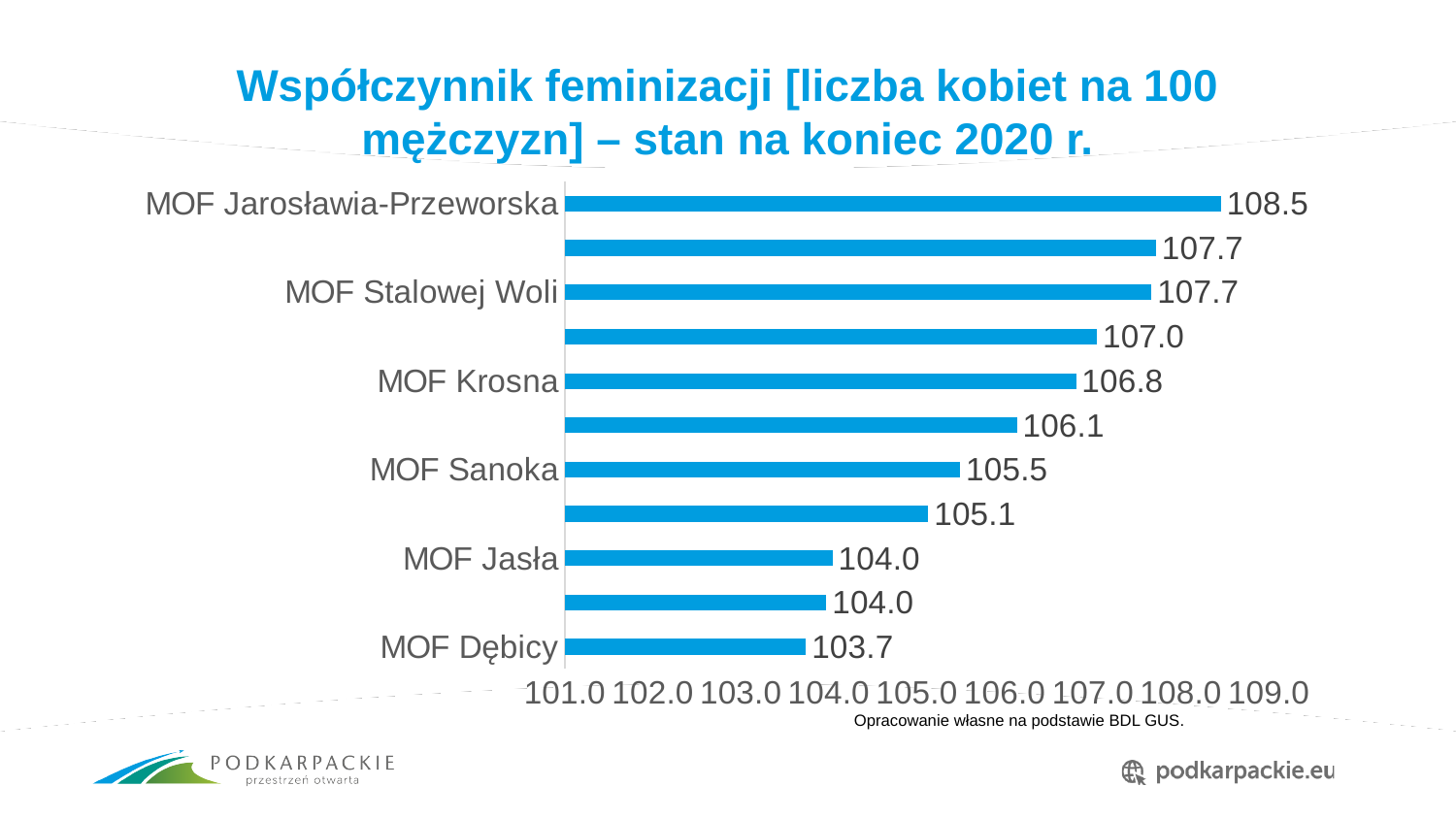
What is the difference between the values for MOF Jarosławia-Przeworska and MOF Dębicy? 4.8 Which labelled area has the highest feminization coefficient? MOF Jarosławia-Przeworska What type of chart is shown on the slide? Bar chart Which has a higher value, MOF Stalowej Woli or MOF Krosna? MOF Stalowej Woli What is the value shown for MOF Dębicy? 103.7 What is the value shown for MOF Krosna? 106.8 What is the feminization coefficient for MOF Jarosławia-Przeworska? 108.5 How many bars are plotted in the chart? 11 What is the value shown for MOF Sanoka? 105.5 What is the value shown for MOF Stalowej Woli? 107.7 Which labelled area has the lowest feminization coefficient? MOF Dębicy What is the difference between the values for MOF Krosna and MOF Sanoka? 1.3